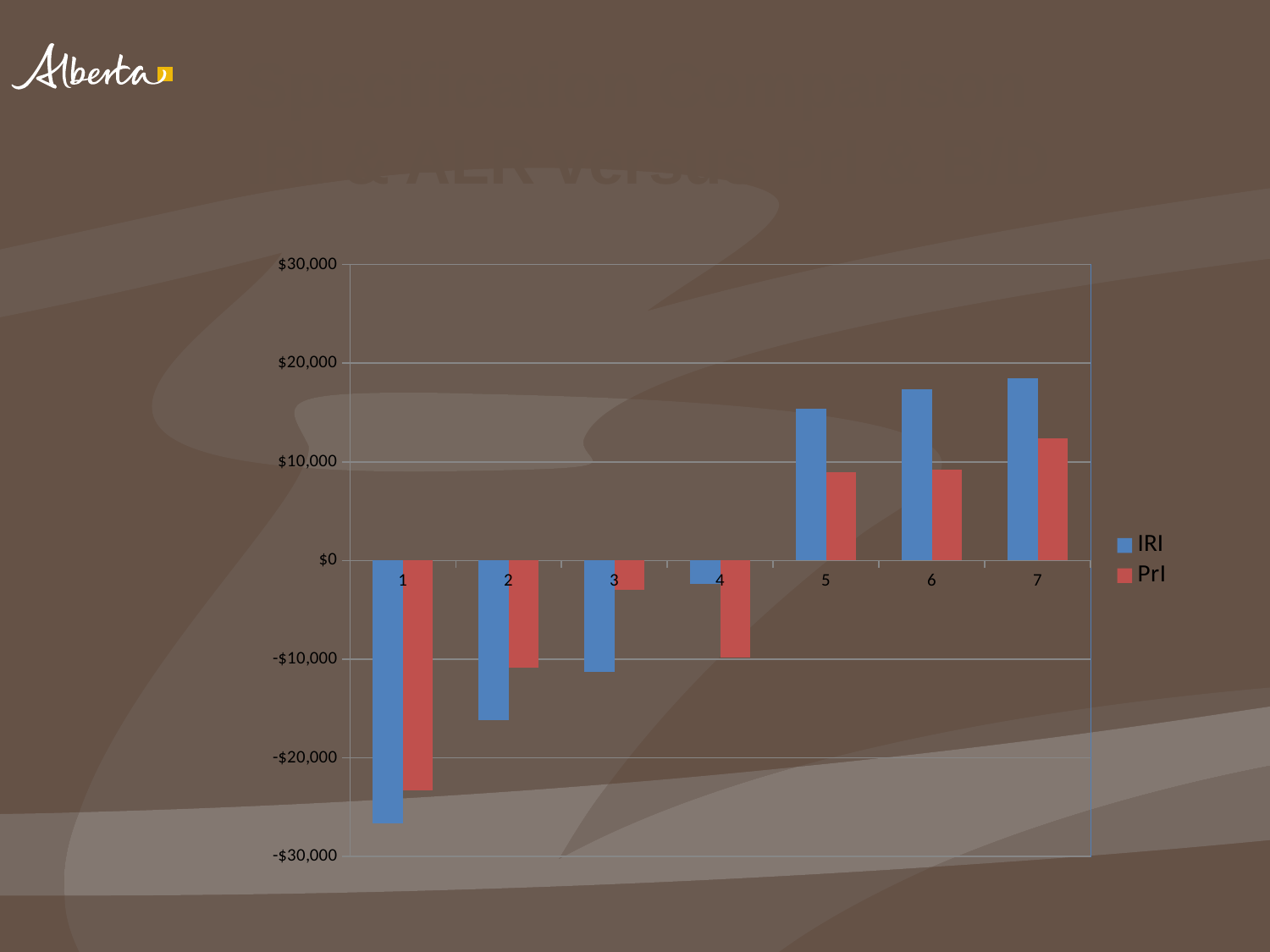
For category 4, which series has the larger value, IRI or PrI? IRI Is the PrI value for category 1 greater or less than -$20,000? less How many categories are shown on the x axis? 7 Which colour represents the PrI series in the legend? red Which category has the highest IRI value? 7 For category 3, which series has the larger value, IRI or PrI? PrI Which category has the lowest PrI value? 1 Which category has the lowest IRI value? 1 How many series does the legend list? 2 Is the IRI value for category 5 greater or less than $10,000? greater Is the IRI value for category 2 greater or less than -$10,000? less What kind of chart is shown on the slide? bar chart